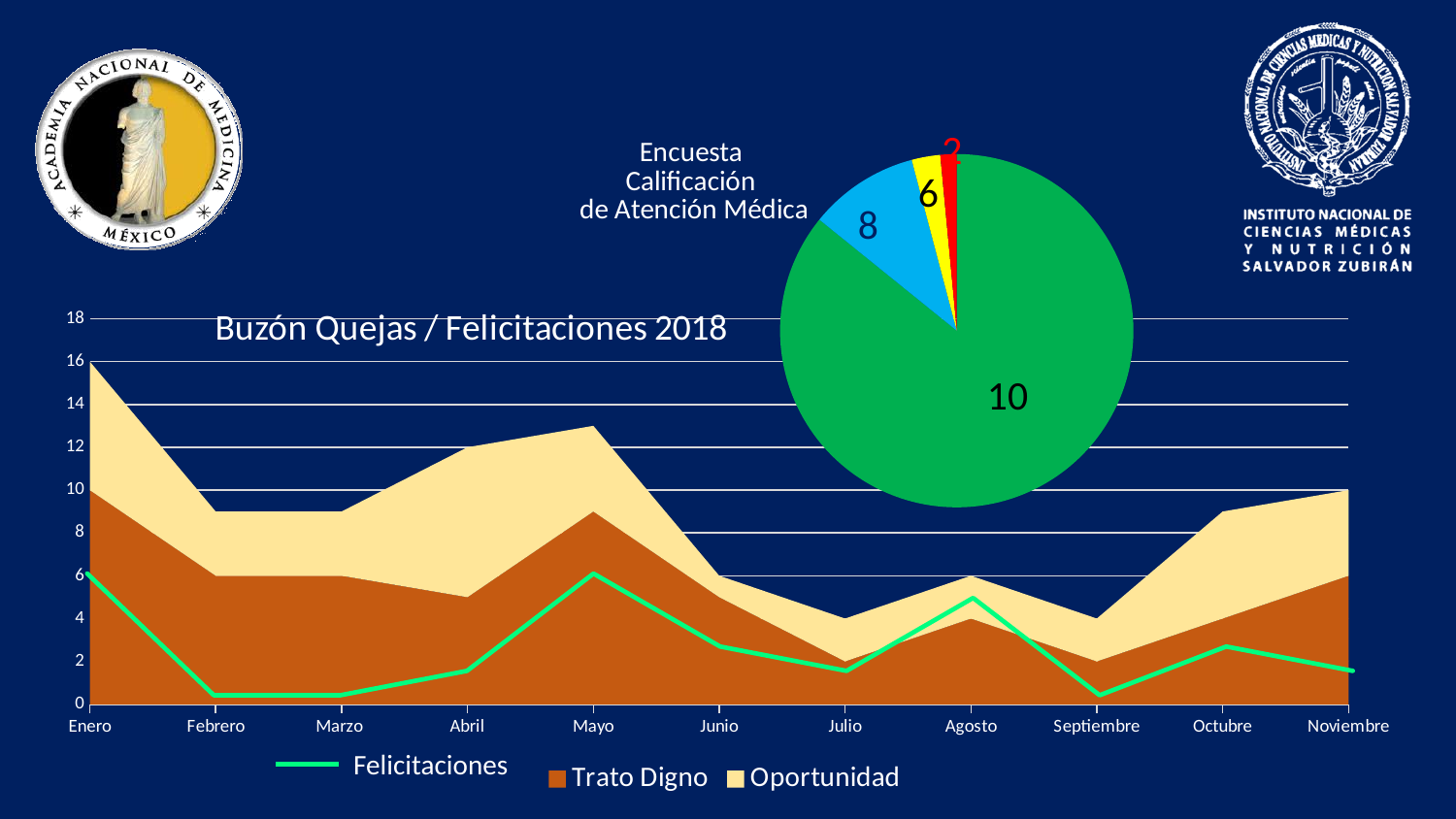
In the Buzón Quejas / Felicitaciones 2018 chart, how many series does the legend list? 3 In the Buzón Quejas / Felicitaciones 2018 chart, which series is drawn as a green line? Felicitaciones In the Buzón Quejas / Felicitaciones 2018 chart, is the Felicitaciones value larger in Agosto or in Septiembre? Agosto What is the title of the chart at the bottom of the slide? Buzón Quejas / Felicitaciones 2018 In the Buzón Quejas / Felicitaciones 2018 chart, how many months are shown on the x axis? 11 In the Encuesta Calificación de Atención Médica pie chart, how many slices are there? 4 In the Buzón Quejas / Felicitaciones 2018 chart, is the Trato Digno value for Enero greater or less than 8? greater In the Buzón Quejas / Felicitaciones 2018 chart, is the Felicitaciones value for Septiembre greater or less than 2? less What kind of chart is the Encuesta Calificación de Atención Médica chart? pie chart In the Buzón Quejas / Felicitaciones 2018 chart, is the Felicitaciones value for Mayo greater or less than 4? greater In the Encuesta Calificación de Atención Médica pie chart, what value is labelled on the largest (green) slice? 10 In the Buzón Quejas / Felicitaciones 2018 chart, does the Felicitaciones line rise or fall from Enero to Febrero? fall